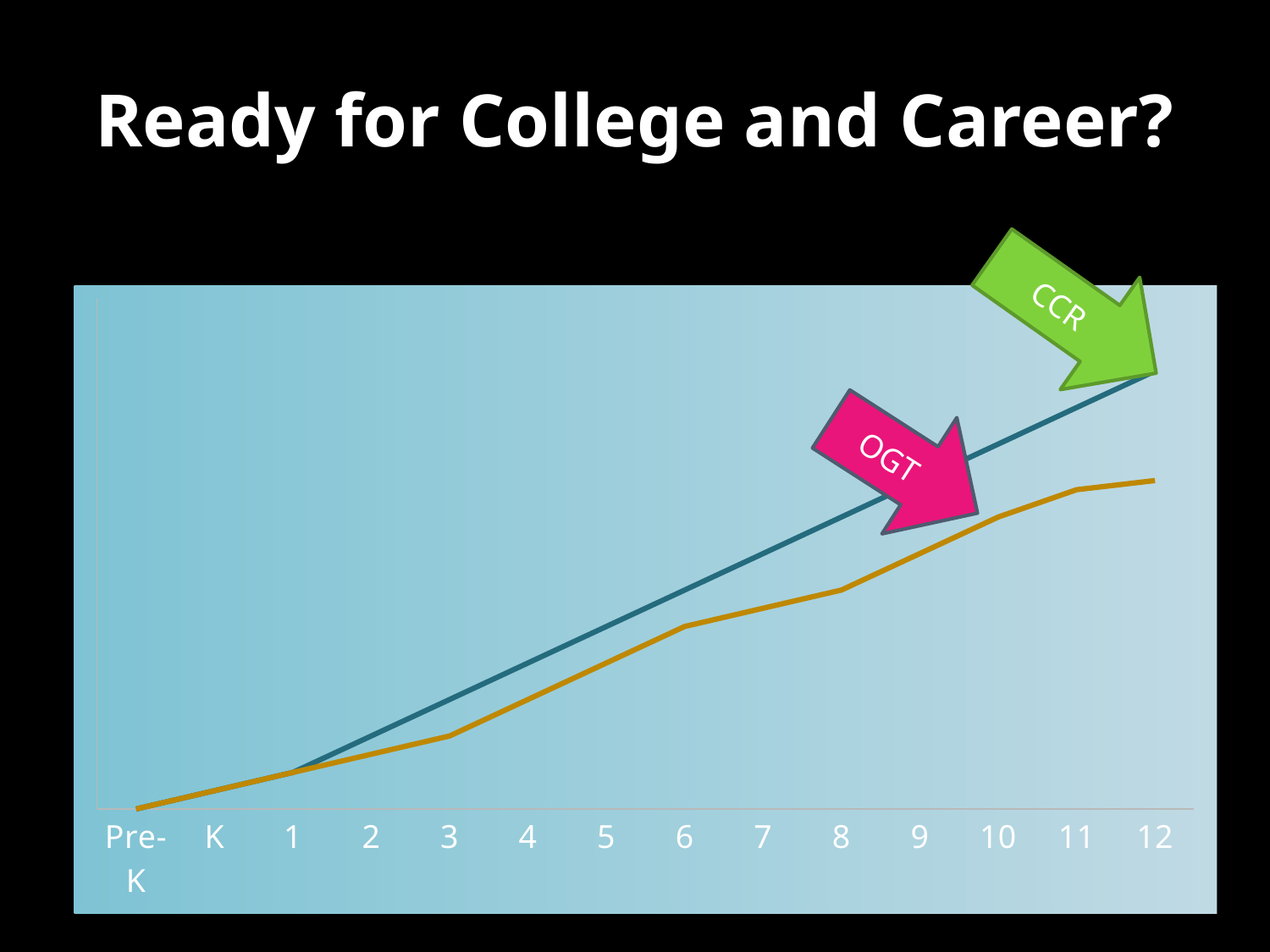
How many lines are plotted on the chart? 2 What is the title of the slide containing the chart? Ready for College and Career? What kind of chart is shown on the slide? Line chart At grade 12, which line is higher, the blue line or the orange line? The blue line Do the values of the orange line rise or fall from Pre-K to 12? Rise What is the last category on the x axis of the chart? 12 How many categories are shown on the x axis of the chart? 14 What label is on the green arrow pointing at the blue line? CCR Do the values of the blue line rise or fall from Pre-K to 12? Rise At grade 6, which line is higher, the blue line or the orange line? The blue line What is the first category on the x axis of the chart? Pre-K